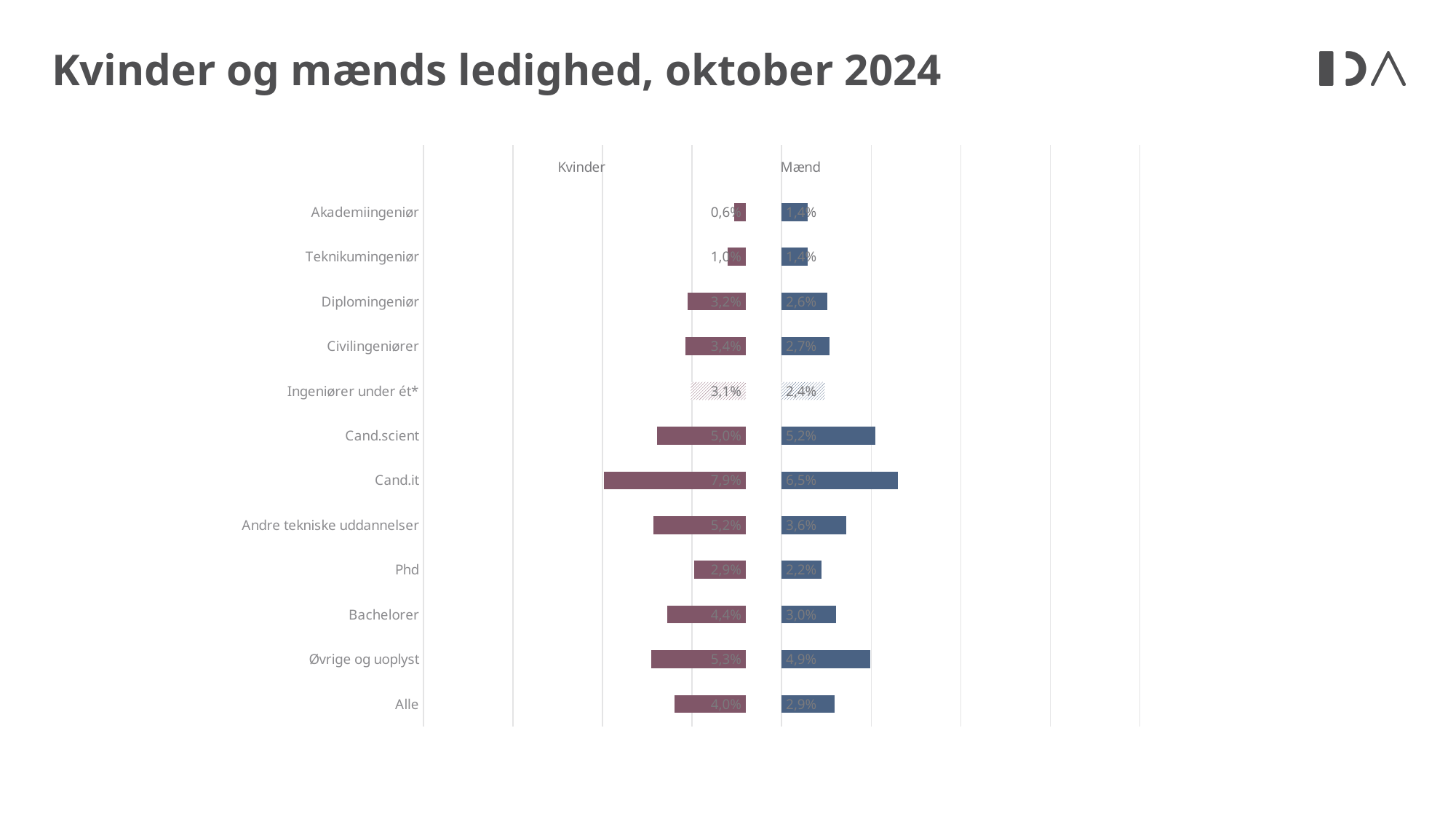
What is the unemployment rate for Mænd in the Cand.scient category? 5,2% What is the value for Mænd in the Akademiingeniør category? 1,4% What is the difference between the Kvinder and Mænd values for Andre tekniske uddannelser? 1,6% Which category has the highest value for Kvinder? Cand.it Which category has the highest value for Mænd? Cand.it Which category has the lowest value for Kvinder? Akademiingeniør How many education categories are shown in the chart? 12 How many series does the chart show? 2 What is the unemployment rate for Kvinder in the Cand.it category? 7,9% What is the value for Kvinder in the Alle category? 4,0% What kind of chart is shown on the slide? Bar chart For Cand.scient, which is larger: the Kvinder value or the Mænd value? Mænd